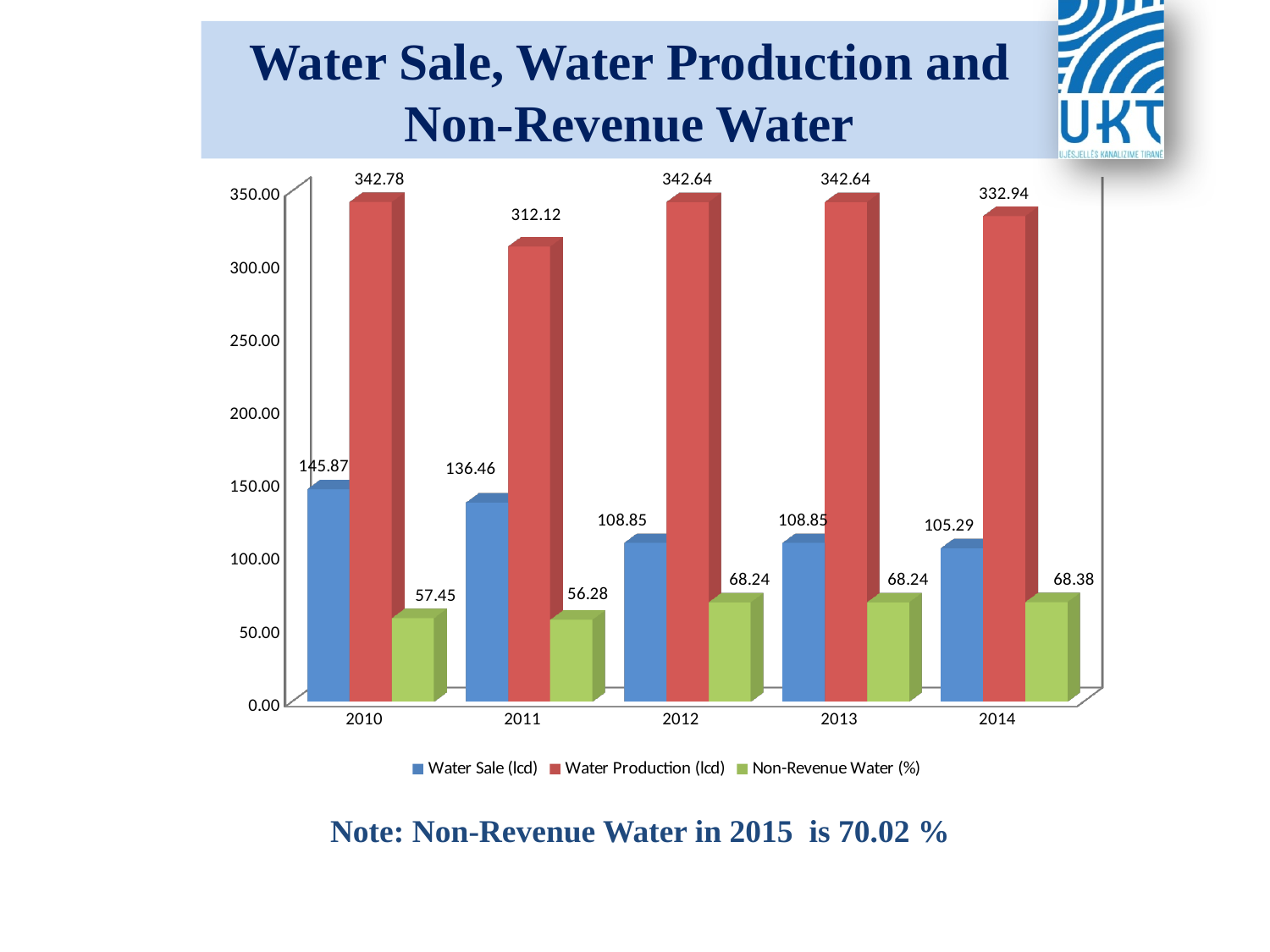
Which is larger: Non-Revenue Water (%) in 2010 or in 2014? 2014 Which year has the highest Water Sale (lcd) value? 2010 Does the Water Sale (lcd) series rise or fall from 2010 to 2014? fall What is the Non-Revenue Water (%) value for 2011? 56.28 How many years are shown on the x axis? 5 What kind of chart is shown on the slide? bar chart How many series does the legend list? 3 Is the Water Sale (lcd) value for 2011 greater or less than 150.00? less What is the Water Production (lcd) value for 2010? 342.78 Which year has the lowest Water Production (lcd) value? 2011 What is the difference between Water Production (lcd) and Water Sale (lcd) in 2012? 233.79 What is the Water Sale (lcd) value for 2014? 105.29